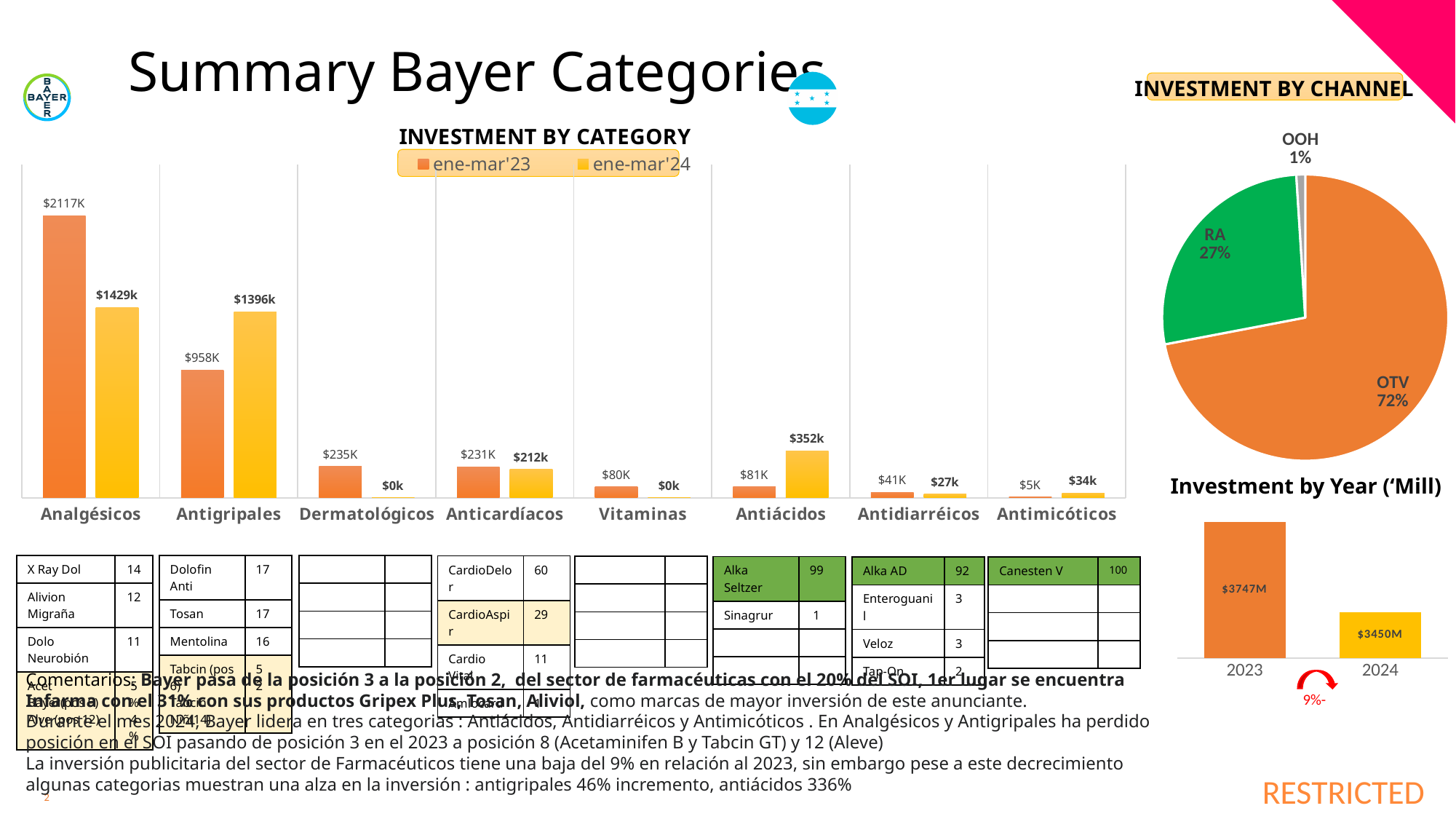
In the INVESTMENT BY CATEGORY chart, which category has the lowest ene-mar'23 value? Antimicóticos How many categories are shown on the x axis of the INVESTMENT BY CATEGORY chart? 8 In the INVESTMENT BY CHANNEL pie chart, what share does OTV have? 72% In the INVESTMENT BY CATEGORY chart, what is the ene-mar'24 value for Antiácidos? $352k In the Investment by Year ('Mill) chart, what is the value for 2024? $3450M In the INVESTMENT BY CHANNEL pie chart, which channel has the smallest slice? OOH In the INVESTMENT BY CATEGORY chart, which category has the highest ene-mar'24 value? Analgésicos How many series does the legend of the INVESTMENT BY CATEGORY chart list? 2 In the Investment by Year ('Mill) chart, do values rise or fall from 2023 to 2024? Fall In the INVESTMENT BY CATEGORY chart, which is larger for Antigripales: the ene-mar'23 value or the ene-mar'24 value? ene-mar'24 What kind of chart is the INVESTMENT BY CATEGORY chart? Bar chart In the INVESTMENT BY CATEGORY chart, what is the ene-mar'23 value for Analgésicos? $2117K